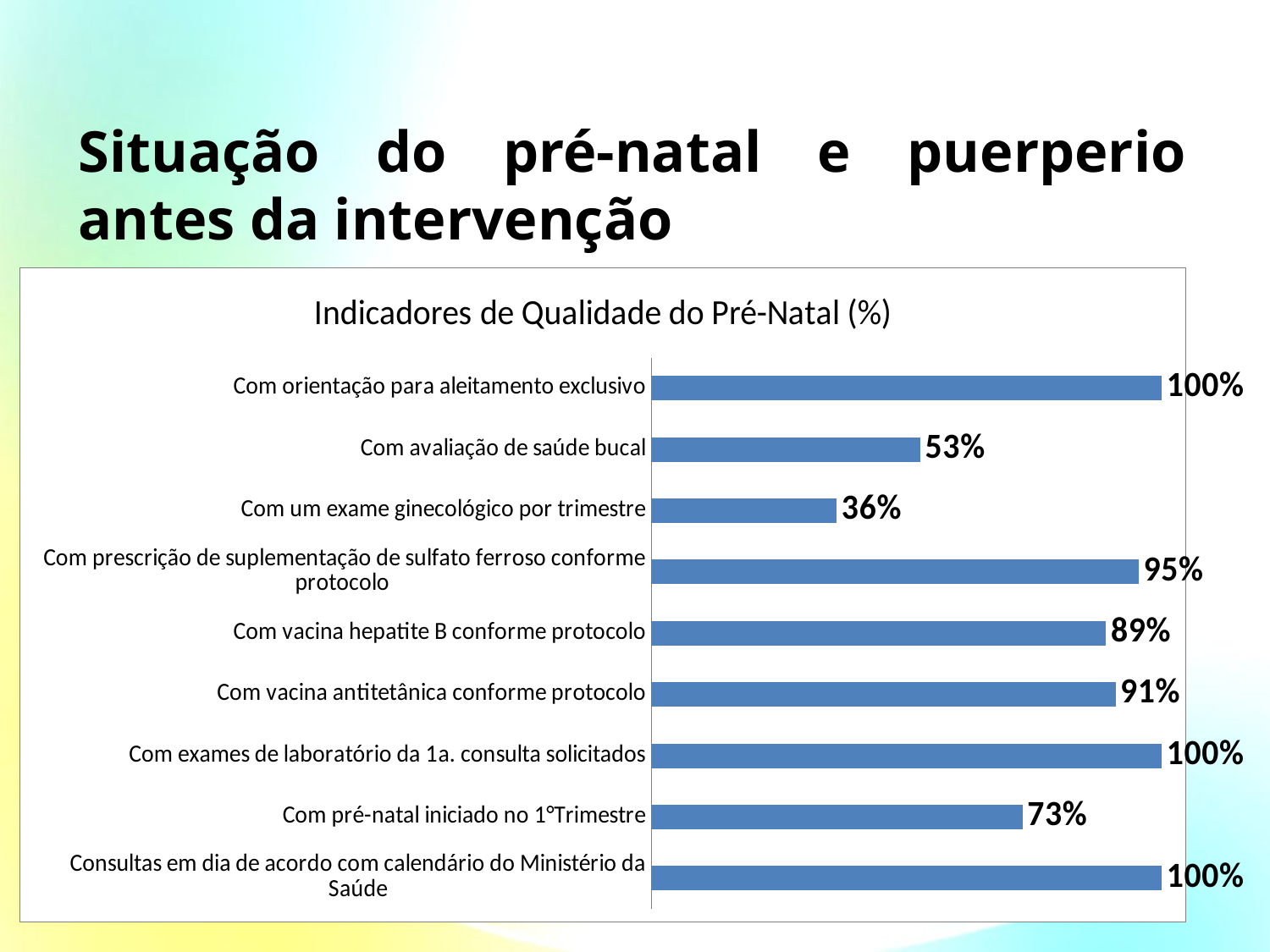
How many categories have a value of 100%? 3 What is the value for "Com vacina hepatite B conforme protocolo"? 89% What is the value for "Com avaliação de saúde bucal"? 53% How many categories are shown in the chart? 9 What is the value for "Com pré-natal iniciado no 1°Trimestre"? 73% Which is larger: "Com pré-natal iniciado no 1°Trimestre" or "Com avaliação de saúde bucal"? Com pré-natal iniciado no 1°Trimestre What kind of chart is shown? Bar chart What is the difference between "Com vacina antitetânica conforme protocolo" and "Com vacina hepatite B conforme protocolo"? 2% Which category has the lowest value? Com um exame ginecológico por trimestre What is the value for "Com um exame ginecológico por trimestre"? 36% What is the title of the chart? Indicadores de Qualidade do Pré-Natal (%) What is the difference between "Com prescrição de suplementação de sulfato ferroso conforme protocolo" and "Com avaliação de saúde bucal"? 42%